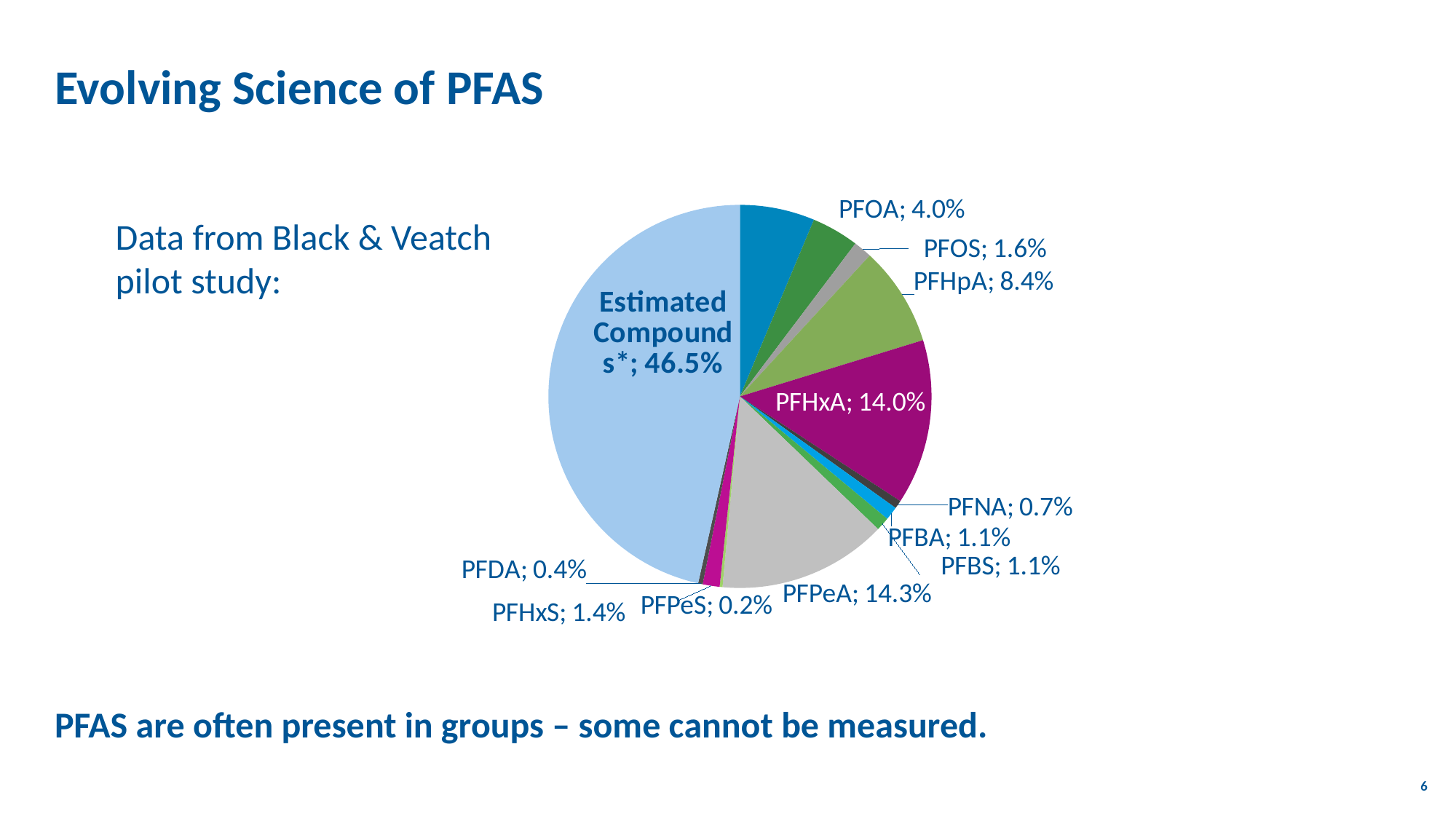
Which labelled slice has the smallest share of the pie? PFPeS What percentage is shown for PFHpA? 8.4% What share of the pie is labelled as Estimated Compounds*? 46.5% Which labelled slice has the largest share of the pie? Estimated Compounds* According to the slide, where does the data in the chart come from? Black & Veatch pilot study Which is larger, the PFHpA slice or the PFOA slice? PFHpA What is the difference between the PFOA and PFOS percentages? 2.4% What percentage does the PFHxA slice represent? 14.0% What kind of chart is shown on the slide? pie chart What is the value labelled for PFOA? 4.0% What is the difference between the PFPeA and PFHxA percentages? 0.3% What percentage is shown for PFPeA? 14.3%